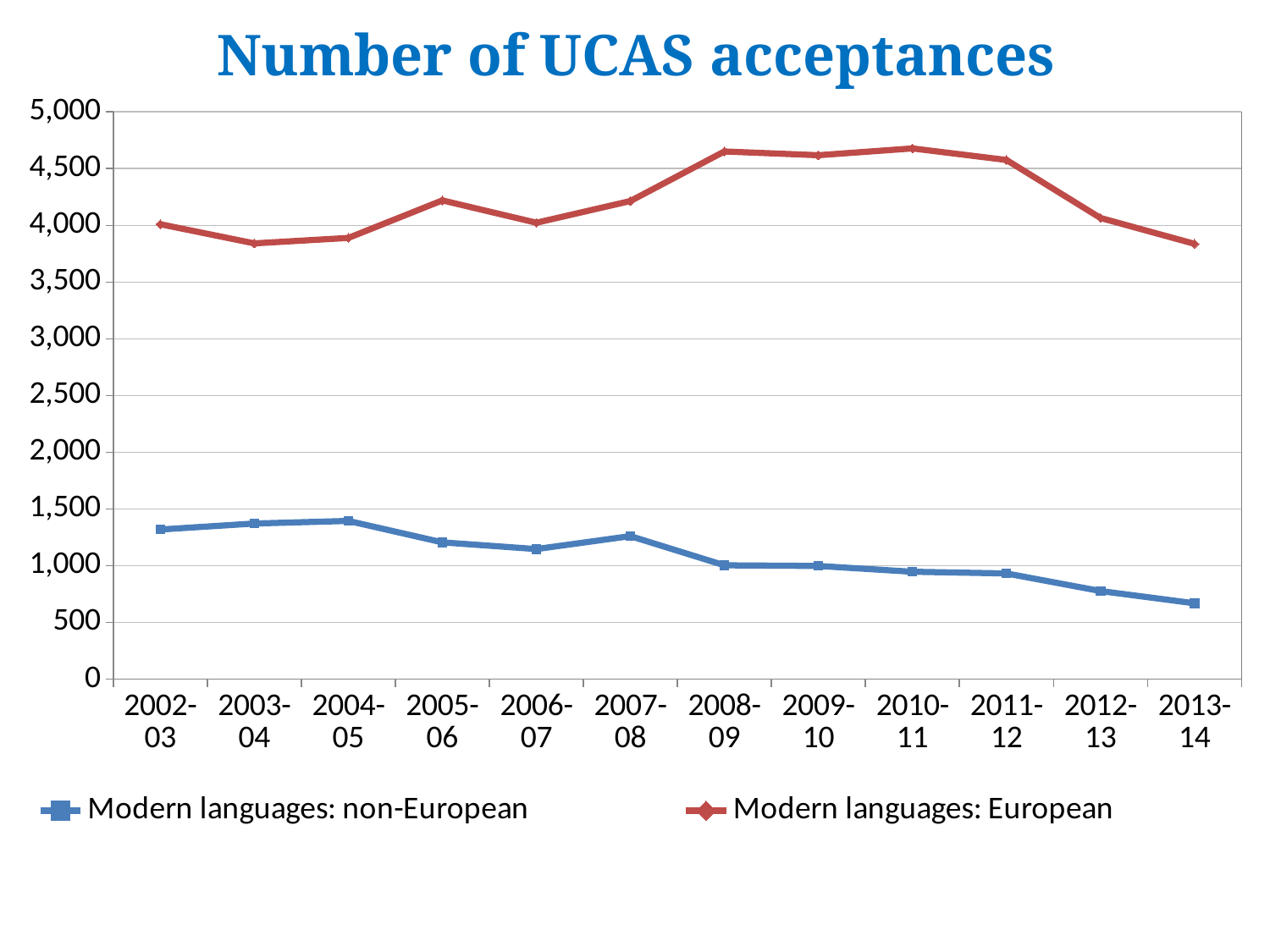
For Modern languages: European, which year has the larger value, 2005-06 or 2006-07? 2005-06 Overall, does the Modern languages: non-European series rise or fall from 2002-03 to 2013-14? fall How many academic years are plotted along the x axis? 12 Is the value for Modern languages: non-European in 2013-14 greater or less than 1,000? less Is the value for Modern languages: European in 2008-09 greater or less than 4,500? greater How many series does the legend list? 2 Is the value for Modern languages: European in 2003-04 greater or less than 4,000? less For Modern languages: non-European, which year has the larger value, 2007-08 or 2008-09? 2007-08 What kind of chart is shown on the slide? line chart In which year is the Modern languages: non-European series at its lowest? 2013-14 What is the title of the chart? Number of UCAS acceptances